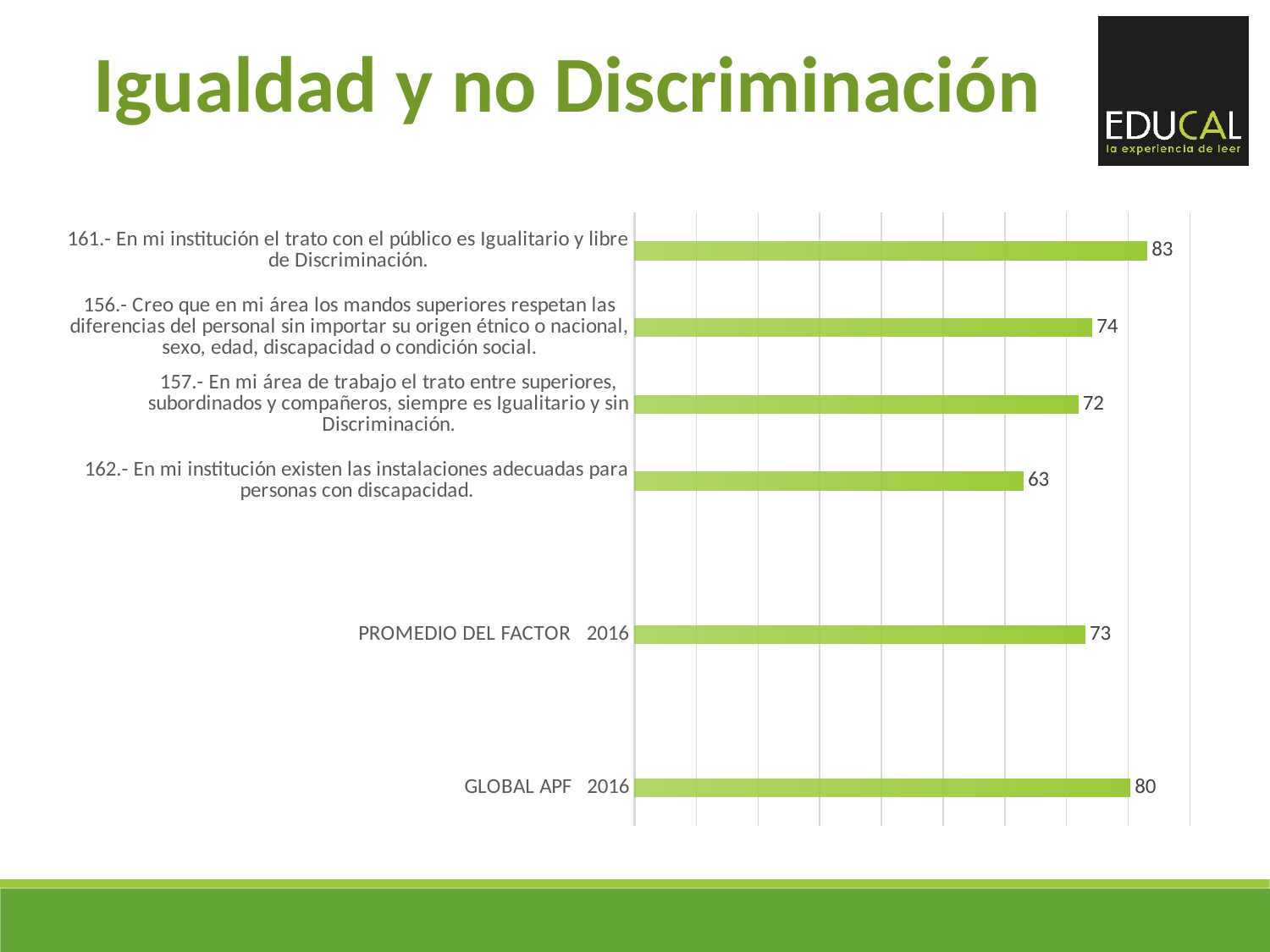
What is the value for item 161 (trato con el público es Igualitario y libre de Discriminación)? 83 What is the value for PROMEDIO DEL FACTOR 2016? 73 Which bar has the lowest value? 162.- En mi institución existen las instalaciones adecuadas para personas con discapacidad. Which is larger, the value for item 156 or the value for item 157? 156.- Creo que en mi área los mandos superiores respetan las diferencias del personal sin importar su origen étnico o nacional, sexo, edad, discapacidad o condición social. What is the difference between the value for item 161 and the value for item 162? 20 What is the value for item 162 (instalaciones adecuadas para personas con discapacidad)? 63 What is the title of the slide containing the chart? Igualdad y no Discriminación How many bars are plotted in the chart? 6 Which bar has the highest value? 161.- En mi institución el trato con el público es Igualitario y libre de Discriminación. What is the value for GLOBAL APF 2016? 80 What kind of chart is shown on the slide? Bar chart What is the difference between GLOBAL APF 2016 and PROMEDIO DEL FACTOR 2016? 7